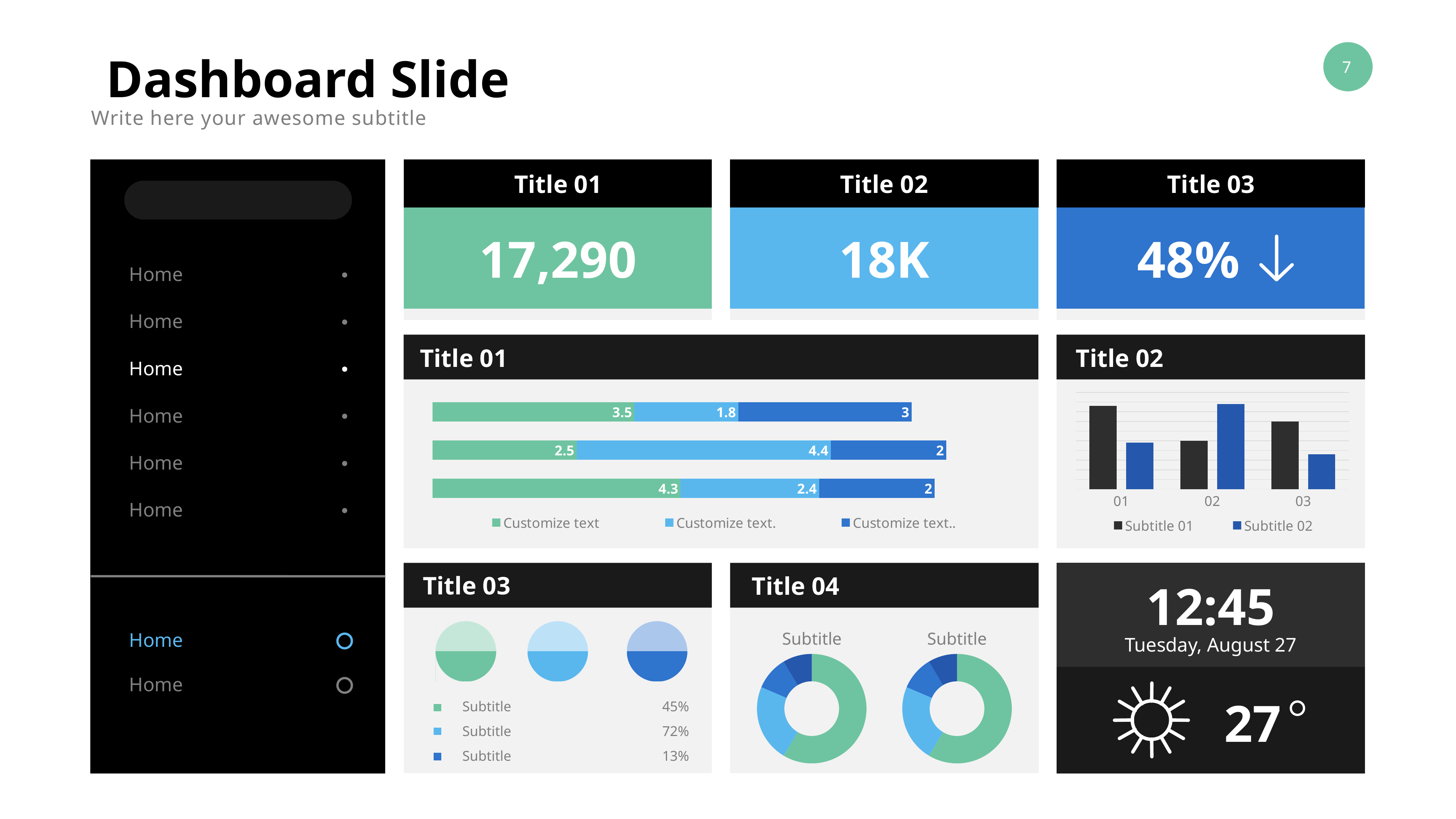
In the "Title 02" bar chart, at category 01, which bar is taller: "Subtitle 01" or "Subtitle 02"? Subtitle 01 How many series does the legend of the "Title 01" bar chart list? 3 In the "Title 01" bar chart, which bar has the largest "Customize text" (green) value? the bottom bar In the "Title 02" bar chart, which category has the tallest "Subtitle 02" bar? 02 In the "Title 01" bar chart, what is the "Customize text." (light blue) value of the middle bar? 4.4 What kind of chart is shown in the "Title 02" panel on the right of the slide? bar chart In the "Title 01" bar chart, what is the "Customize text" (green) value of the top bar? 3.5 In the "Title 01" bar chart, what is the difference between the "Customize text" and "Customize text." values of the top bar? 1.7 In the "Title 01" bar chart, what is the total of the bottom stacked bar? 8.7 What kind of chart is shown in the "Title 01" panel in the middle of the slide? bar chart How many bars are plotted in the "Title 01" bar chart? 3 How many series does the legend of the "Title 02" bar chart list? 2